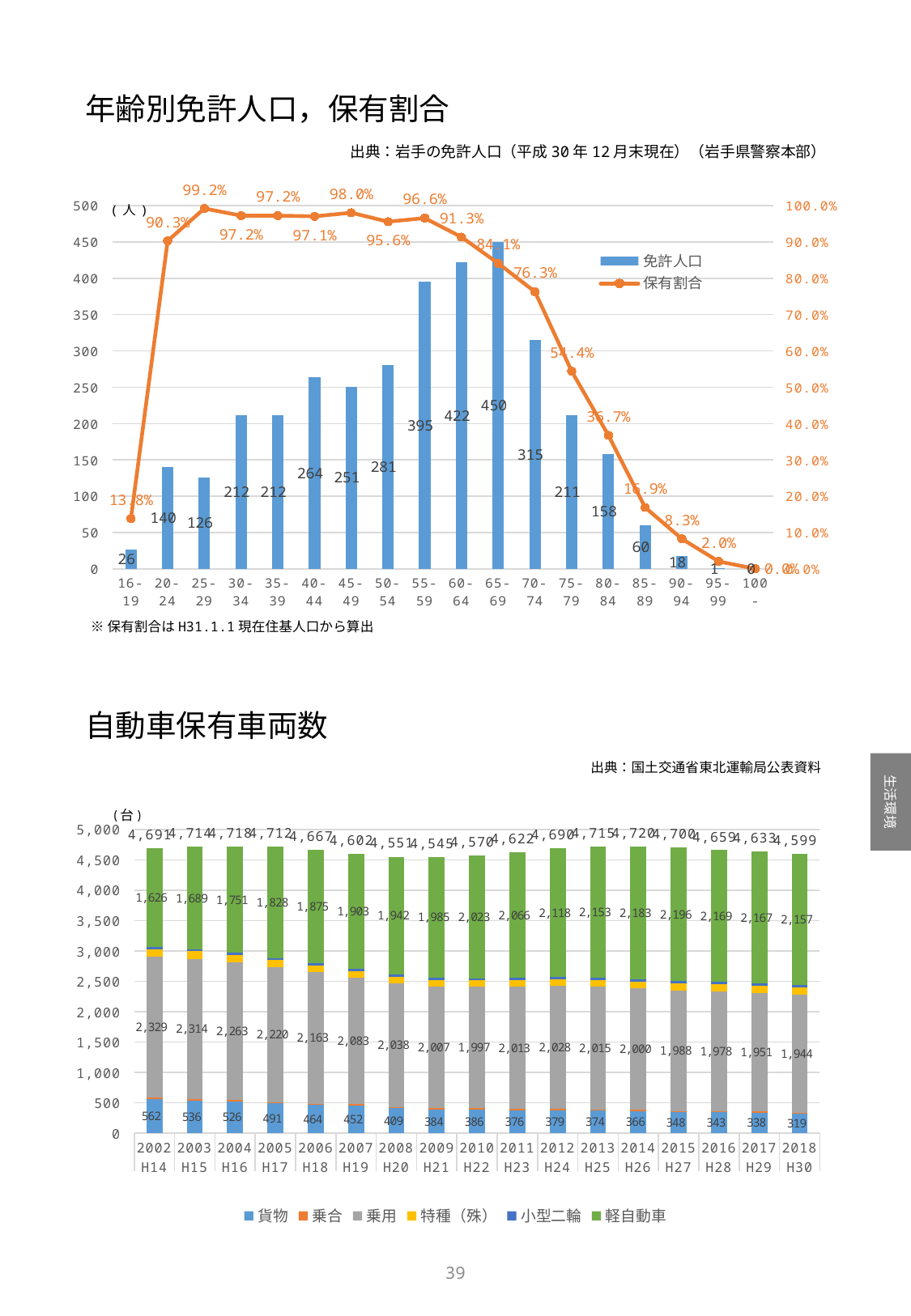
In the 年齢別免許人口，保有割合 chart, does the 保有割合 rise or fall from the 70-74 age group to the 95-99 age group? fall In the 年齢別免許人口，保有割合 chart, what is the 免許人口 value for the 65-69 age group? 450 In the 年齢別免許人口，保有割合 chart, which age group has the highest 免許人口? 65-69 In the 自動車保有車両数 chart, what is the total number of vehicles in 2013 (H25)? 4,715 In the 年齢別免許人口，保有割合 chart, which is larger, the 免許人口 for 20-24 or for 25-29? 20-24 In the 自動車保有車両数 chart, what is the 貨物 value for 2002 (H14)? 562 In the 年齢別免許人口，保有割合 chart, what is the difference in 免許人口 between the 60-64 and 55-59 age groups? 27 What kind of chart is the 自動車保有車両数 chart? stacked bar chart In the 年齢別免許人口，保有割合 chart, what is the 保有割合 for the 25-29 age group? 99.2% In the 自動車保有車両数 chart, what is the 軽自動車 value for 2018 (H30)? 2,157 In the 自動車保有車両数 chart, how many series does the legend list? 6 In the 年齢別免許人口，保有割合 chart, how many series does the legend list? 2